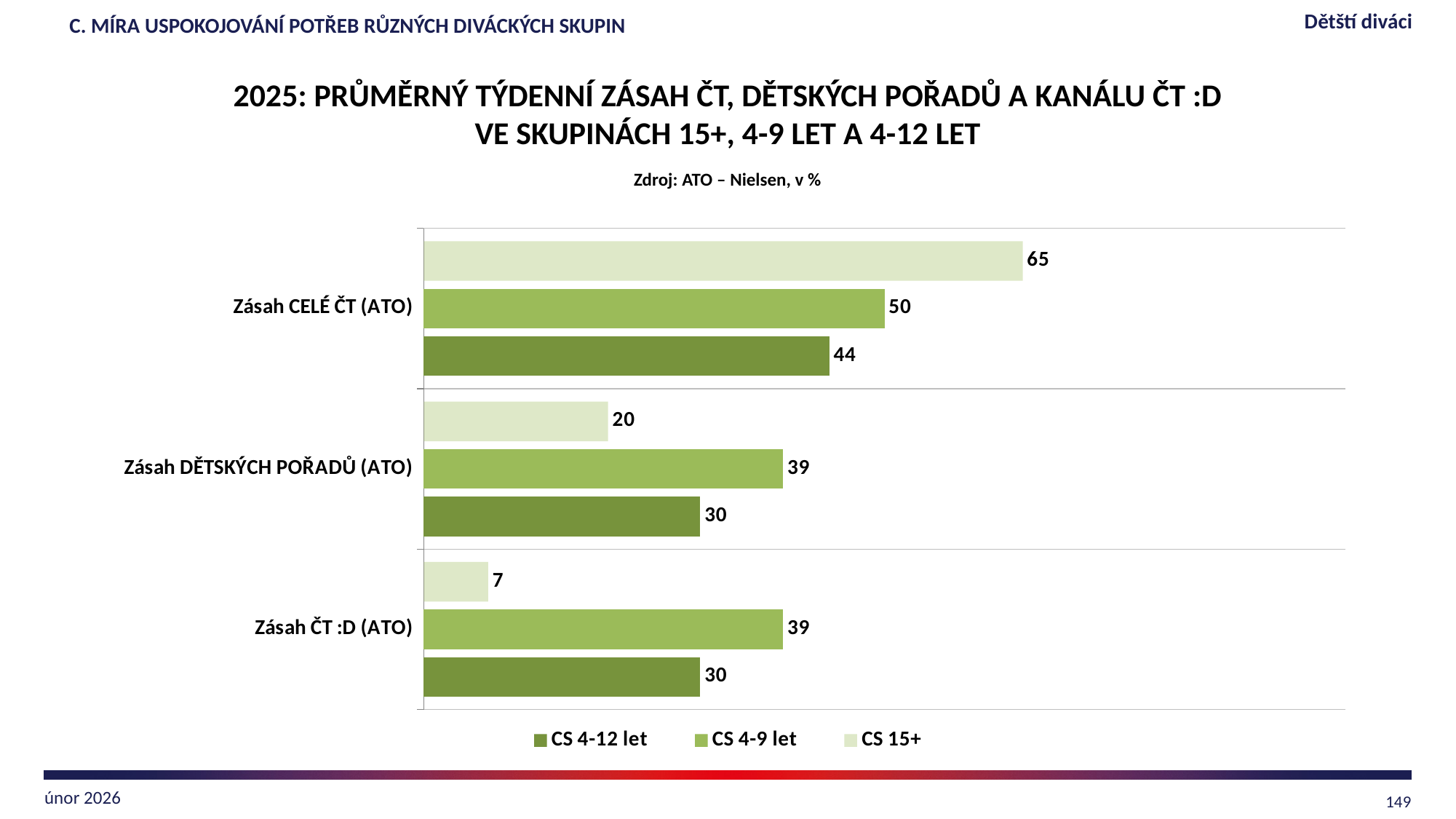
What is the value for CS 4-9 let in the Zásah DĚTSKÝCH POŘADŮ (ATO) category? 39 Which category has the lowest value for the CS 15+ series? Zásah ČT :D (ATO) What is the value for CS 4-12 let in the Zásah ČT :D (ATO) category? 30 What is the value for CS 15+ in the Zásah ČT :D (ATO) category? 7 In the Zásah DĚTSKÝCH POŘADŮ (ATO) category, which is larger: the CS 4-9 let value or the CS 15+ value? CS 4-9 let What kind of chart is shown on the slide? Bar chart What is the difference between the CS 15+ and CS 4-12 let values in the Zásah CELÉ ČT (ATO) category? 21 What is the value for CS 15+ in the Zásah CELÉ ČT (ATO) category? 65 How many categories are shown on the chart? 3 What source is cited below the chart title? ATO – Nielsen, v % Which category has the highest value for the CS 15+ series? Zásah CELÉ ČT (ATO) How many series does the legend list? 3